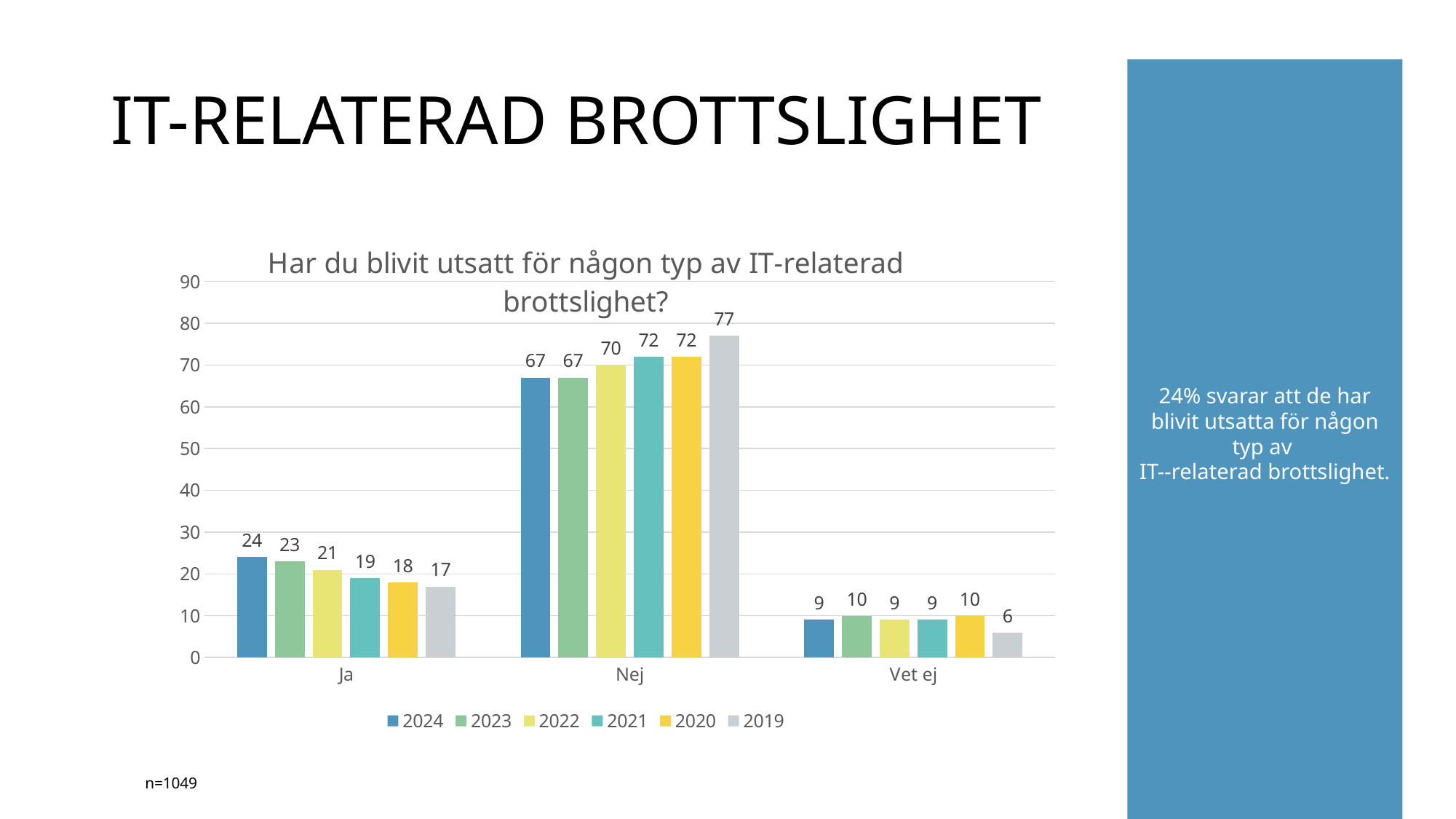
Which year has the highest value in the "Nej" category? 2019 Is the value for 2020 in the "Nej" category greater or less than 70? greater How many response categories are shown on the x axis? 3 What kind of chart is shown on the slide? Bar chart What is the difference between the 2024 and 2019 values in the "Ja" category? 7 Do the values in the "Ja" category rise or fall from 2024 to 2019 (left to right)? Fall What is the value for 2019 in the "Nej" category? 77 Which is larger in the "Nej" category: the value for 2022 or the value for 2021? 2021 What is the value for 2021 in the "Vet ej" category? 9 How many series does the legend list? 6 What is the value for 2024 in the "Ja" category? 24 Which year has the lowest value in the "Ja" category? 2019